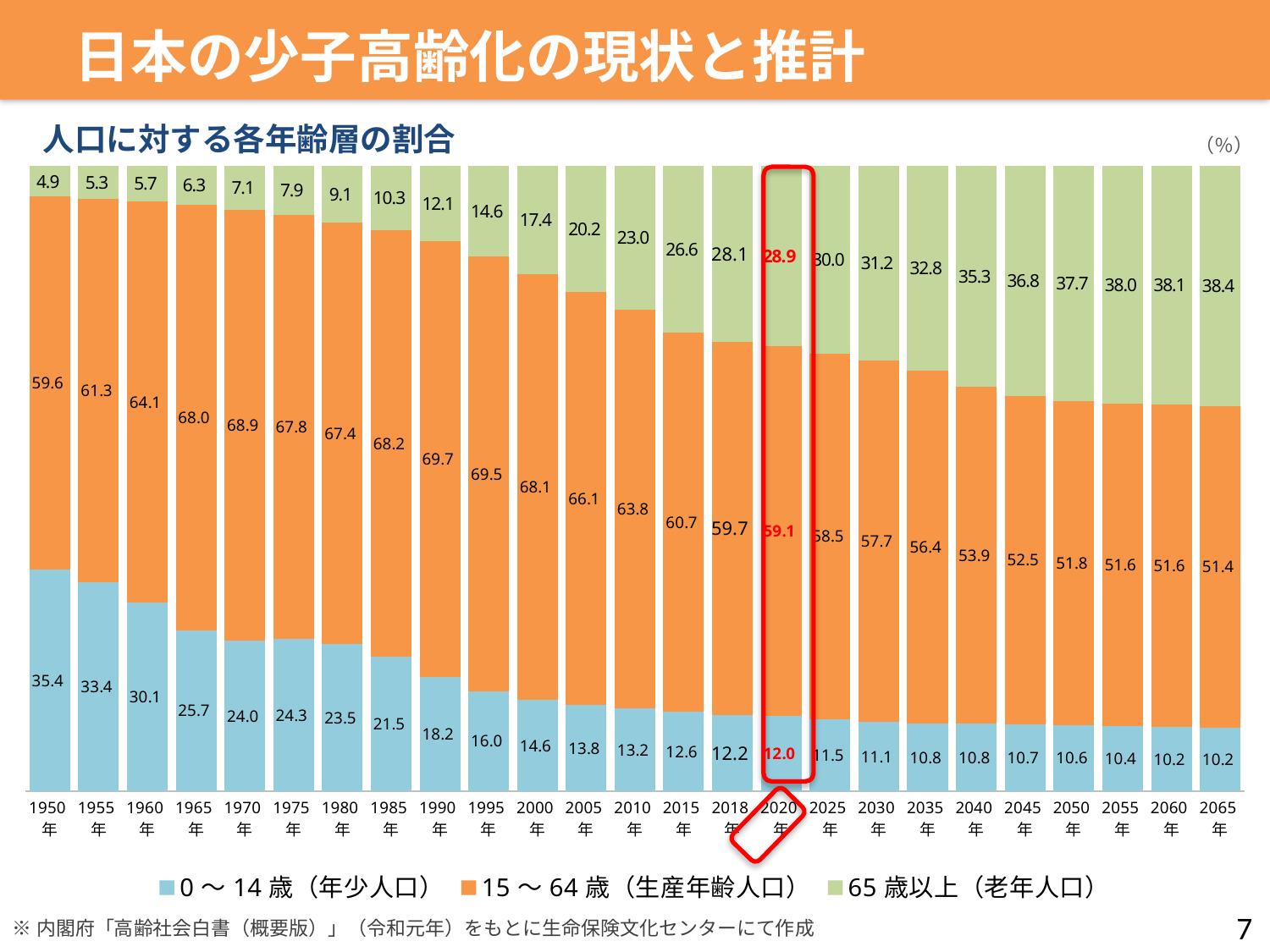
In which year is the 15～64歳（生産年齢人口） share highest? 1990年 How many series does the legend list? 3 Which is larger in 2020年: the 0～14歳（年少人口） value or the 65歳以上（老年人口） value? 65歳以上（老年人口） What kind of chart is shown on the slide? Stacked bar chart What is the value for 0～14歳（年少人口） in 1950年? 35.4 In which year is the 65歳以上（老年人口） share highest? 2065年 How does the 0～14歳（年少人口） share change from 1950年 to 2065年? It falls What is the value for 15～64歳（生産年齢人口） in 2065年? 51.4 How many years (categories) are plotted along the x axis? 25 What is the value for 65歳以上（老年人口） in 2020年? 28.9 Which year is highlighted with a red box on the chart? 2020年 What is the difference between the 65歳以上（老年人口） value in 2065年 and in 1950年? 33.5